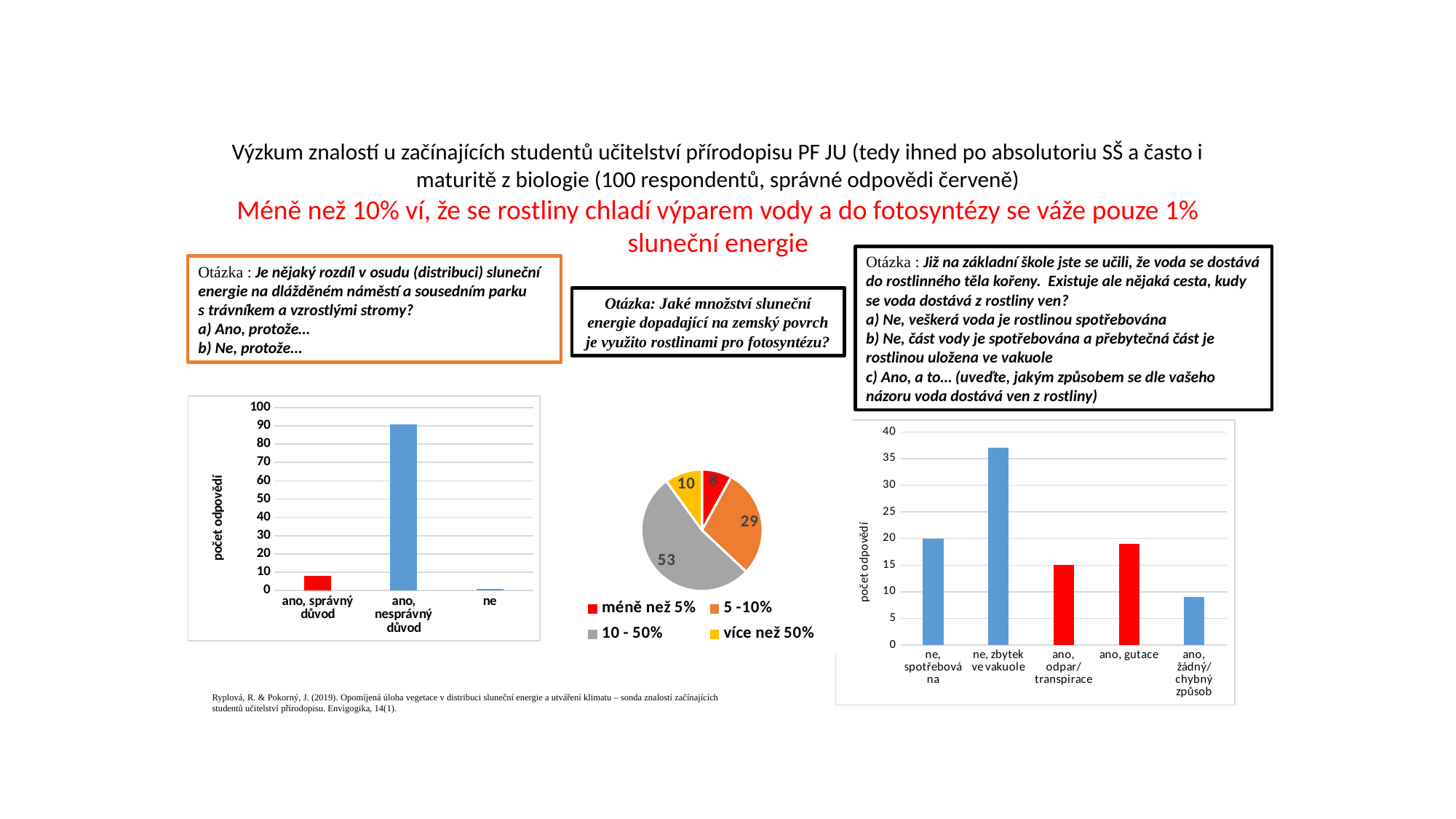
In the left bar chart, which category has the highest bar? ano, nesprávný důvod How many slices does the middle pie chart have? 4 In the middle pie chart, what is the difference between the values for '5 -10%' and 'více než 50%'? 19 In the middle pie chart, what value is shown for the slice '5 -10%'? 29 In the right bar chart, is the value for 'ne, zbytek ve vakuole' greater or less than 35? greater In the left bar chart, is the value for 'ano, správný důvod' greater or less than 10? less In the middle pie chart, which slice is the largest? 10 - 50% What kind of chart is the chart in the middle of the slide? pie chart In the middle pie chart, which slice is the smallest? méně než 5% In the right bar chart, which category has the lowest bar? ano, žádný/chybný způsob What kind of chart is the chart on the left of the slide? bar chart In the middle pie chart, what value is shown for the slice '10 - 50%'? 53